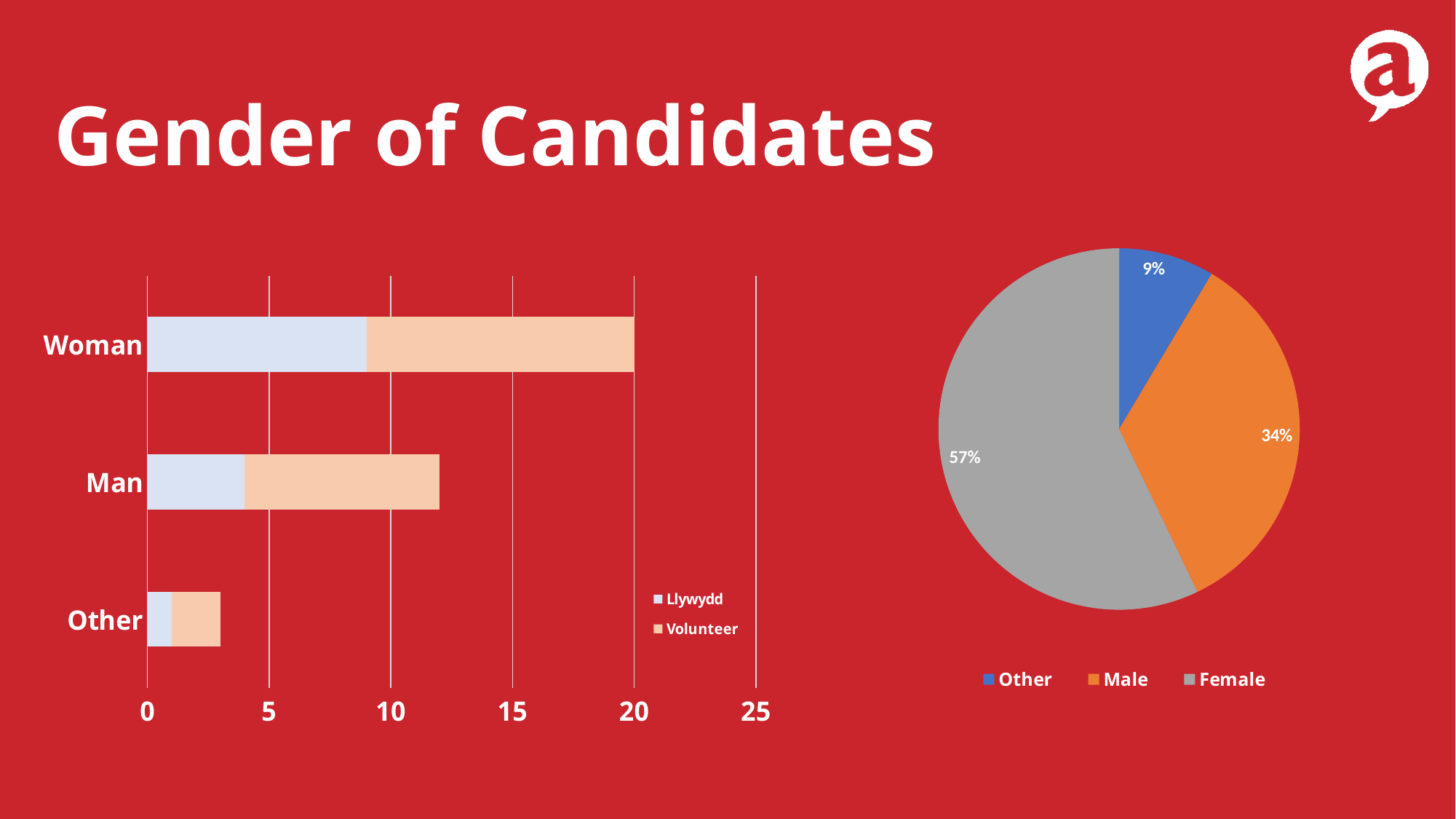
In the bar chart on the left, how many categories are shown on the vertical axis? 3 In the pie chart on the right, how many percentage points larger is the Female share than the Male share? 23 percentage points In the pie chart on the right, which category has the largest slice? Female In the pie chart on the right, which category has the smallest slice? Other In the bar chart on the left, is the total bar length for Other greater or less than 5? less In the pie chart on the right, what share is labelled for Other? 9% In the pie chart on the right, what share is labelled for Female? 57% In the bar chart on the left, is the total bar length for Man greater or less than 10? greater What kind of chart is the chart on the left of the slide? bar chart In the bar chart on the left, which category has the longest total bar? Woman In the bar chart on the left, how many series does the legend list? 2 In the pie chart on the right, what share is labelled for Male? 34%